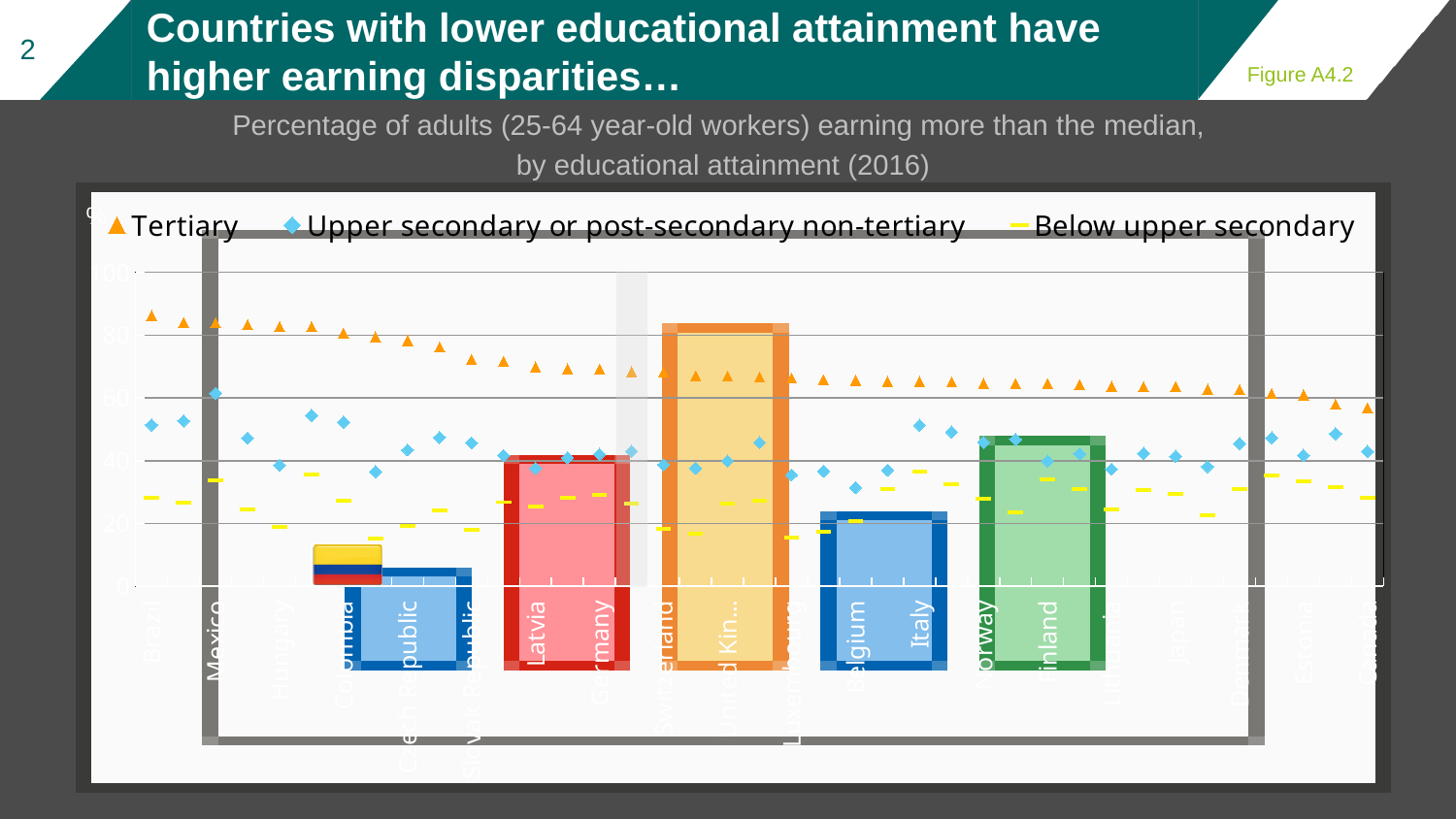
What year is given in the chart's subtitle? 2016 How many series does the chart legend list? 3 Is the Tertiary value for Germany greater or less than 60? greater Do the Tertiary values rise or fall moving from left to right across the countries? fall Is the Tertiary value for Canada greater or less than 60? less Is the Upper secondary or post-secondary non-tertiary value for Mexico greater or less than 40? greater Which series is shown with orange triangle markers? Tertiary Which country has the highest Tertiary value? Brazil For Brazil, which is larger: the Tertiary value or the Below upper secondary value? Tertiary